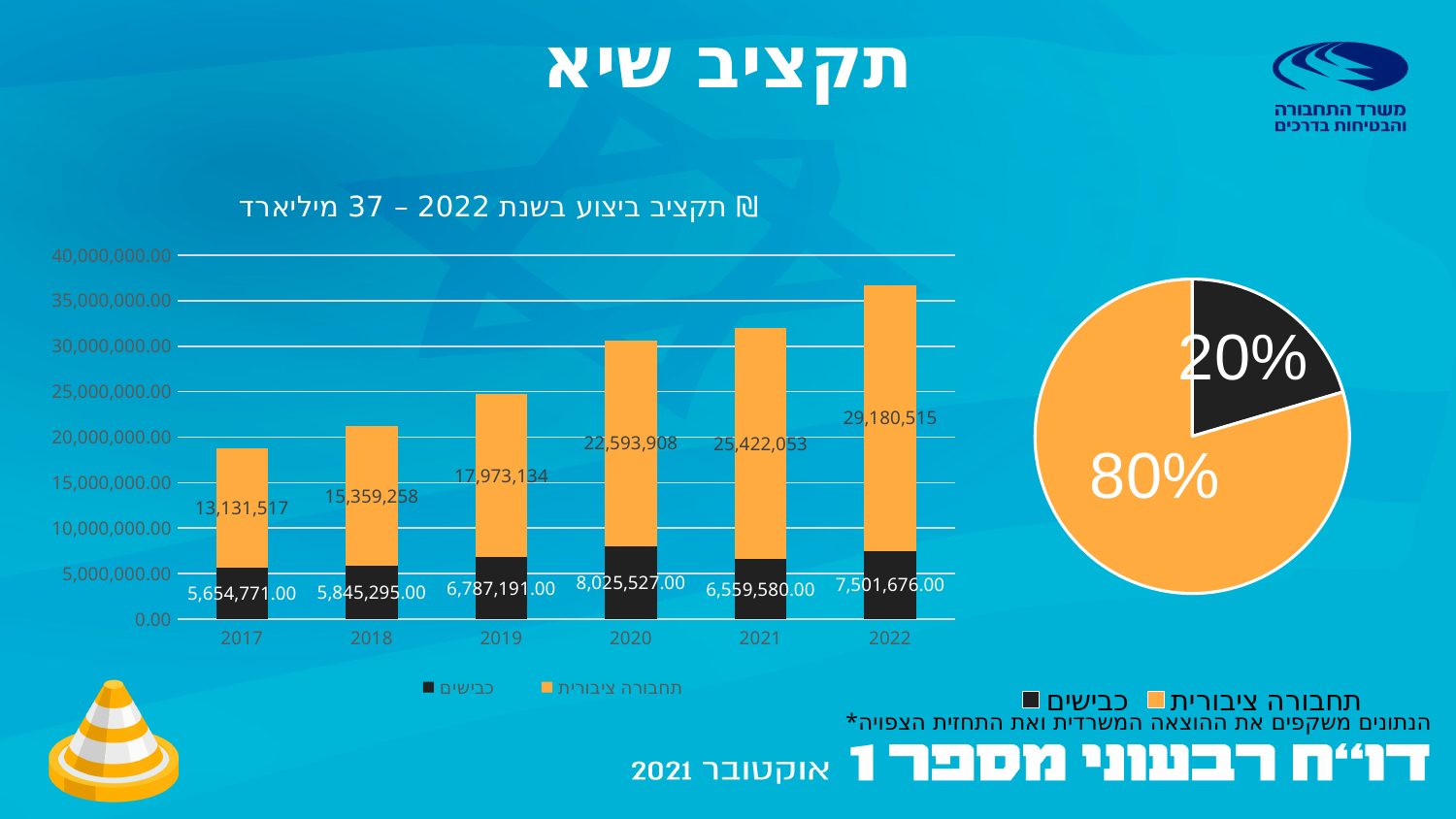
In the bar chart on the left, what is the difference between the תחבורה ציבורית values for 2022 and 2021? 3,758,462 In the pie chart on the right, what share does the orange slice (תחבורה ציבורית) have? 80% How many years are shown on the x axis of the bar chart on the left? 6 In the bar chart on the left, which year has the highest value for תחבורה ציבורית? 2022 How many series does the legend of the bar chart on the left list? 2 In the bar chart on the left, which is larger: the כבישים value for 2020 or for 2021? 2020 In the bar chart on the left, is the total stacked bar for 2022 greater or less than 35,000,000.00? greater In the bar chart on the left, what is the total of the stacked bar for 2017? 18,786,288 In the bar chart on the left, what is the value for כבישים in 2020? 8,025,527.00 In the bar chart on the left, which year has the lowest value for כבישים? 2017 In the bar chart on the left, what is the value for תחבורה ציבורית in 2022? 29,180,515 What kind of chart is the chart on the right side of the slide? Pie chart